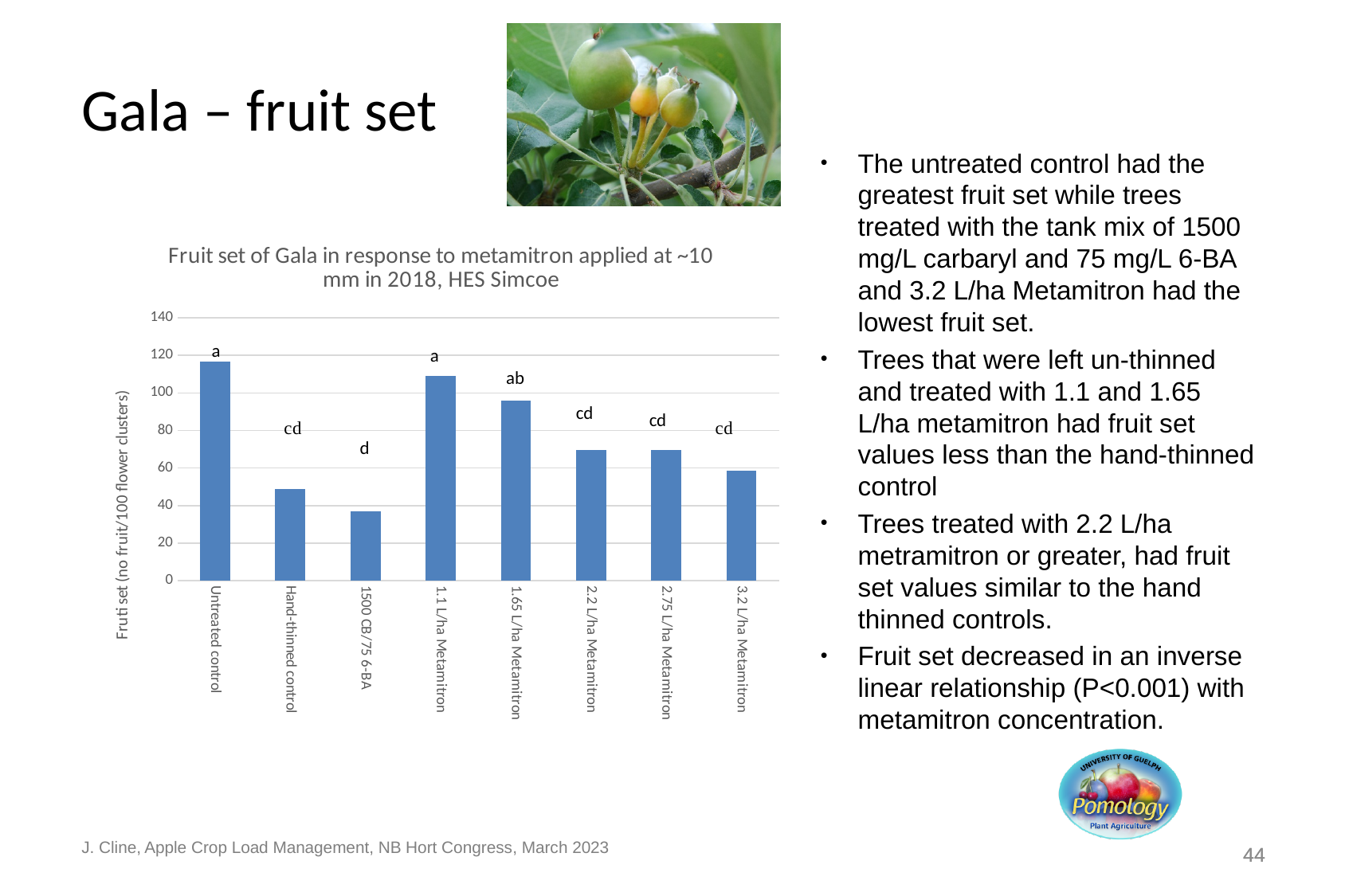
How many treatment categories are plotted on the x axis of the chart? 8 Is the fruit set value for the Untreated control greater or less than 100? greater Which has the larger fruit set, 1.1 L/ha Metamitron or 1.65 L/ha Metamitron? 1.1 L/ha Metamitron Which treatment has the lowest fruit set in the chart? 1500 CB/75 6-BA Is the fruit set value for 3.2 L/ha Metamitron greater or less than 40? greater What statistical letter label is shown above the bar for 1500 CB/75 6-BA? d What kind of chart is shown on the slide? bar chart What is the title of the chart? Fruit set of Gala in response to metamitron applied at ~10 mm in 2018, HES Simcoe Which treatment has the highest fruit set in the chart? Untreated control Is the fruit set value for 1500 CB/75 6-BA greater or less than 40? less Which has the larger fruit set, Hand-thinned control or 2.2 L/ha Metamitron? 2.2 L/ha Metamitron